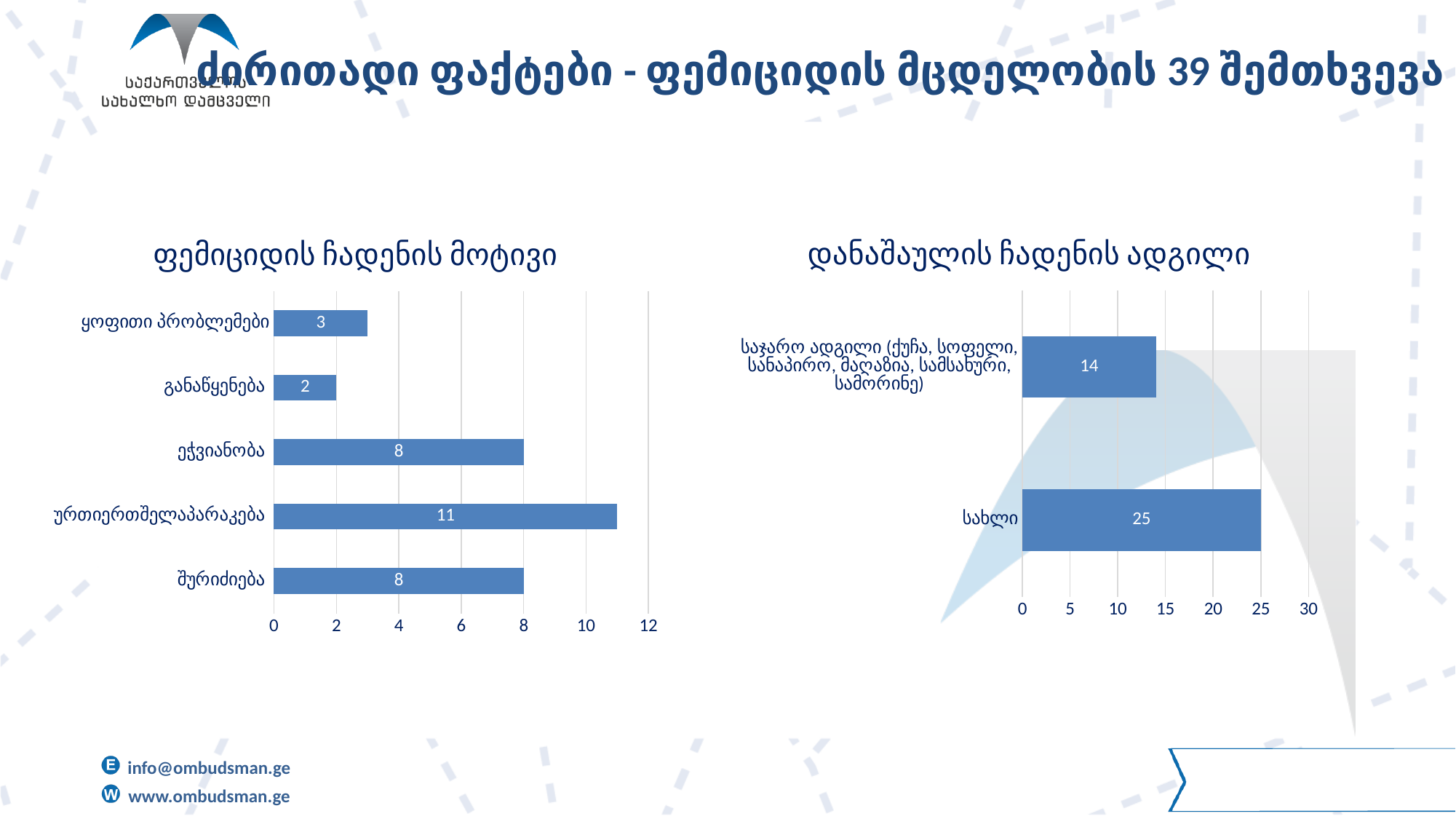
In the left chart (ფემიციდის ჩადენის მოტივი), what is the value for განაწყენება? 2 In the left chart (ფემიციდის ჩადენის მოტივი), what is the difference between ურთიერთშელაპარაკება and ეჭვიანობა? 3 In the left chart (ფემიციდის ჩადენის მოტივი), what is the value for ურთიერთშელაპარაკება? 11 In the right chart (დანაშაულის ჩადენის ადგილი), what is the value for სახლი? 25 In the left chart (ფემიციდის ჩადენის მოტივი), which category has the lowest value? განაწყენება In the left chart (ფემიციდის ჩადენის მოტივი), how many categories are shown? 5 What type of chart is the left chart (ფემიციდის ჩადენის მოტივი)? Bar chart In the right chart (დანაშაულის ჩადენის ადგილი), how many categories are shown? 2 In the left chart (ფემიციდის ჩადენის მოტივი), which is larger: ყოფითი პრობლემები or შურიძიება? შურიძიება In the right chart (დანაშაულის ჩადენის ადგილი), what is the value for საჯარო ადგილი? 14 In the right chart (დანაშაულის ჩადენის ადგილი), what is the difference between სახლი and საჯარო ადგილი? 11 In the left chart (ფემიციდის ჩადენის მოტივი), which category has the highest value? ურთიერთშელაპარაკება